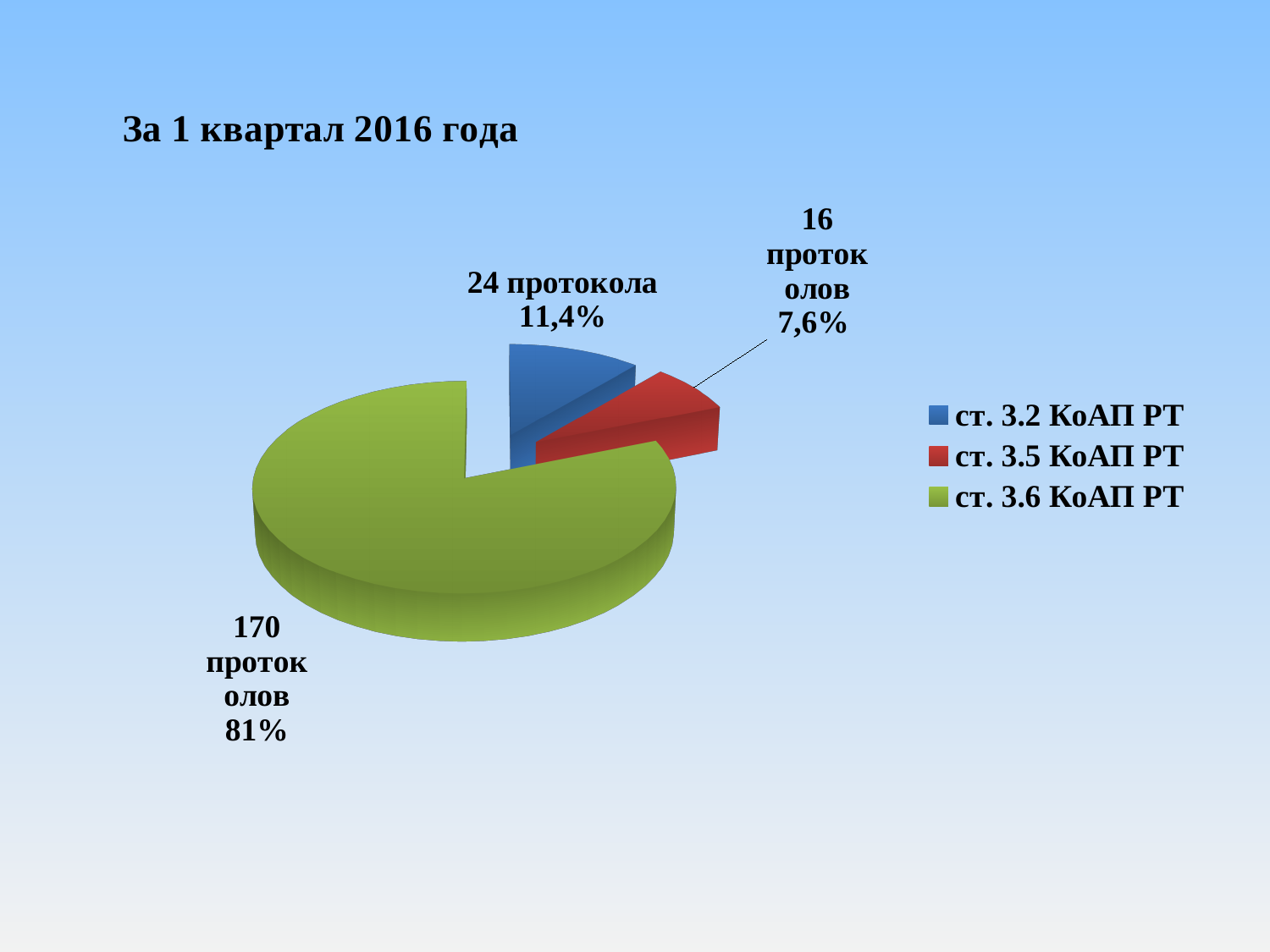
What is the title of the slide above the chart? За 1 квартал 2016 года Which category has the smallest slice of the pie? ст. 3.5 КоАП РТ What share of the pie does ст. 3.5 КоАП РТ account for? 7,6% What share of the pie does ст. 3.6 КоАП РТ account for? 81% How many протоколов are shown for ст. 3.6 КоАП РТ? 170 How many протоколов are shown for ст. 3.2 КоАП РТ? 24 How many протоколов are shown for ст. 3.5 КоАП РТ? 16 What kind of chart is shown on the slide? Pie chart Which category has the largest slice of the pie? ст. 3.6 КоАП РТ What is the difference in the number of протоколов between ст. 3.2 КоАП РТ and ст. 3.5 КоАП РТ? 8 How many slices does the pie chart have? 3 How many entries does the legend list? 3